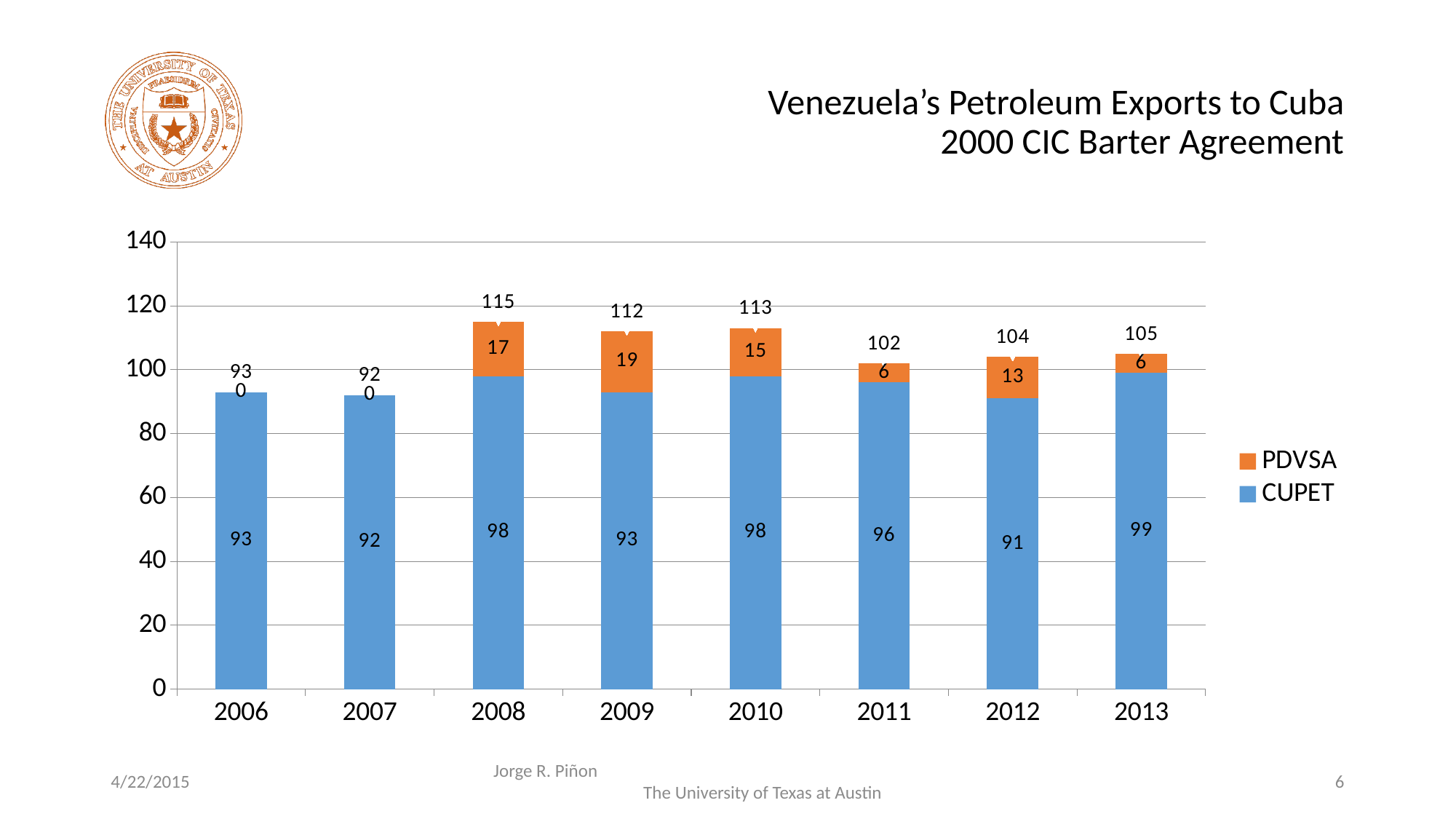
Which year has the lowest total stacked bar? 2007 Which year has the highest total stacked bar? 2008 Which is larger, the PDVSA value for 2008 or the PDVSA value for 2012? 2008 What is the PDVSA value for 2009? 19 What is the CUPET value for 2008? 98 How many series does the legend list? 2 What kind of chart is shown on the slide? Stacked bar chart Which series is shown in orange? PDVSA Is the total for 2011 greater or less than 100? greater What is the difference between the CUPET values for 2013 and 2012? 8 How many years are shown on the x axis? 8 What is the total of the stacked bar for 2010? 113